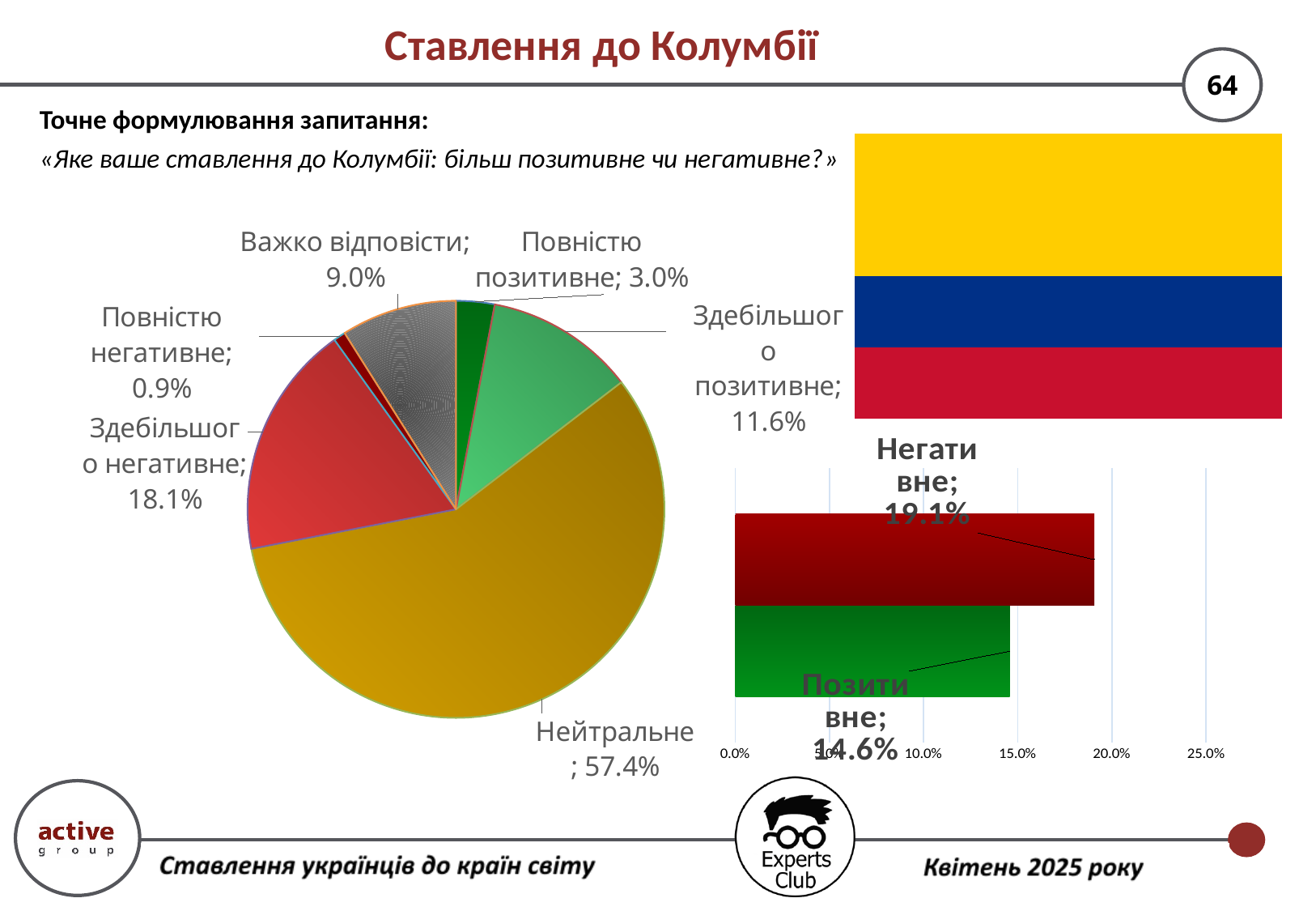
In the pie chart, which category has the largest share? Нейтральне In the pie chart, what is the value for "Здебільшого негативне"? 18.1% In the bar chart, what is the value for "Позитивне"? 14.6% In the bar chart, which is larger, "Негативне" or "Позитивне"? Негативне In the bar chart, what is the value for "Негативне"? 19.1% In the pie chart, what is the difference between "Здебільшого негативне" and "Здебільшого позитивне"? 6.5% In the pie chart, what share of respondents answered "Нейтральне"? 57.4% In the pie chart, what is the value for "Важко відповісти"? 9.0% In the pie chart, which category has the smallest share? Повністю негативне What kind of chart is the chart on the right side of the slide? Bar chart In the pie chart, what is the value for "Повністю позитивне"? 3.0% How many categories does the pie chart show? 6